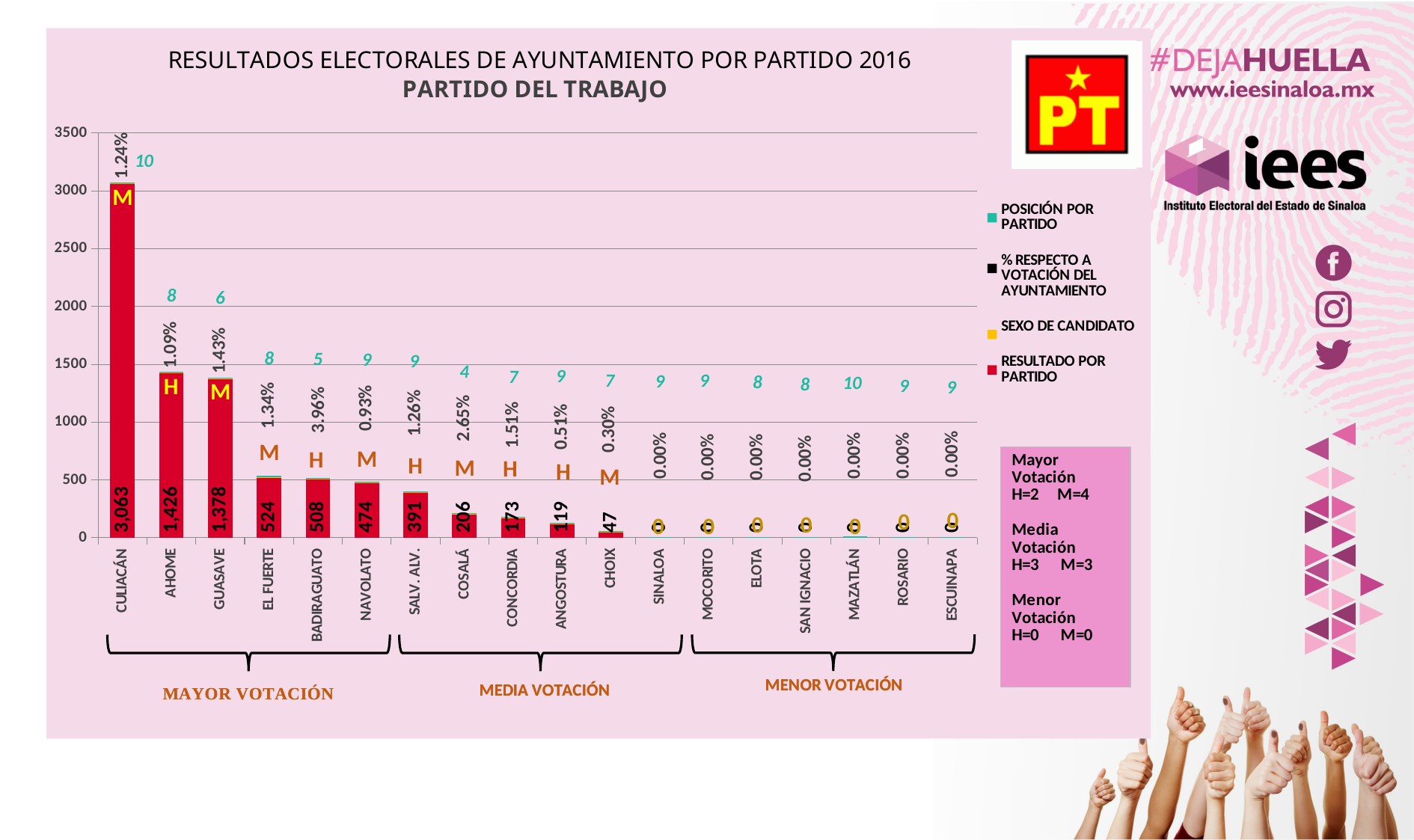
How many series does the legend list? 4 What kind of chart is shown? bar chart How many municipalities are shown on the x axis? 18 What position by party is shown for GUASAVE? 6 What is the result (votes) for CULIACÁN? 3,063 What is the result (votes) for BADIRAGUATO? 508 Which municipality has the highest result for the party? CULIACÁN Which party is named in the chart's subtitle? PARTIDO DEL TRABAJO Which has more votes, EL FUERTE or NAVOLATO? EL FUERTE What is the difference in votes between AHOME and GUASAVE? 48 Is the value for CULIACÁN greater or less than 3000? greater What percentage with respect to the municipal vote is shown for COSALÁ? 2.65%